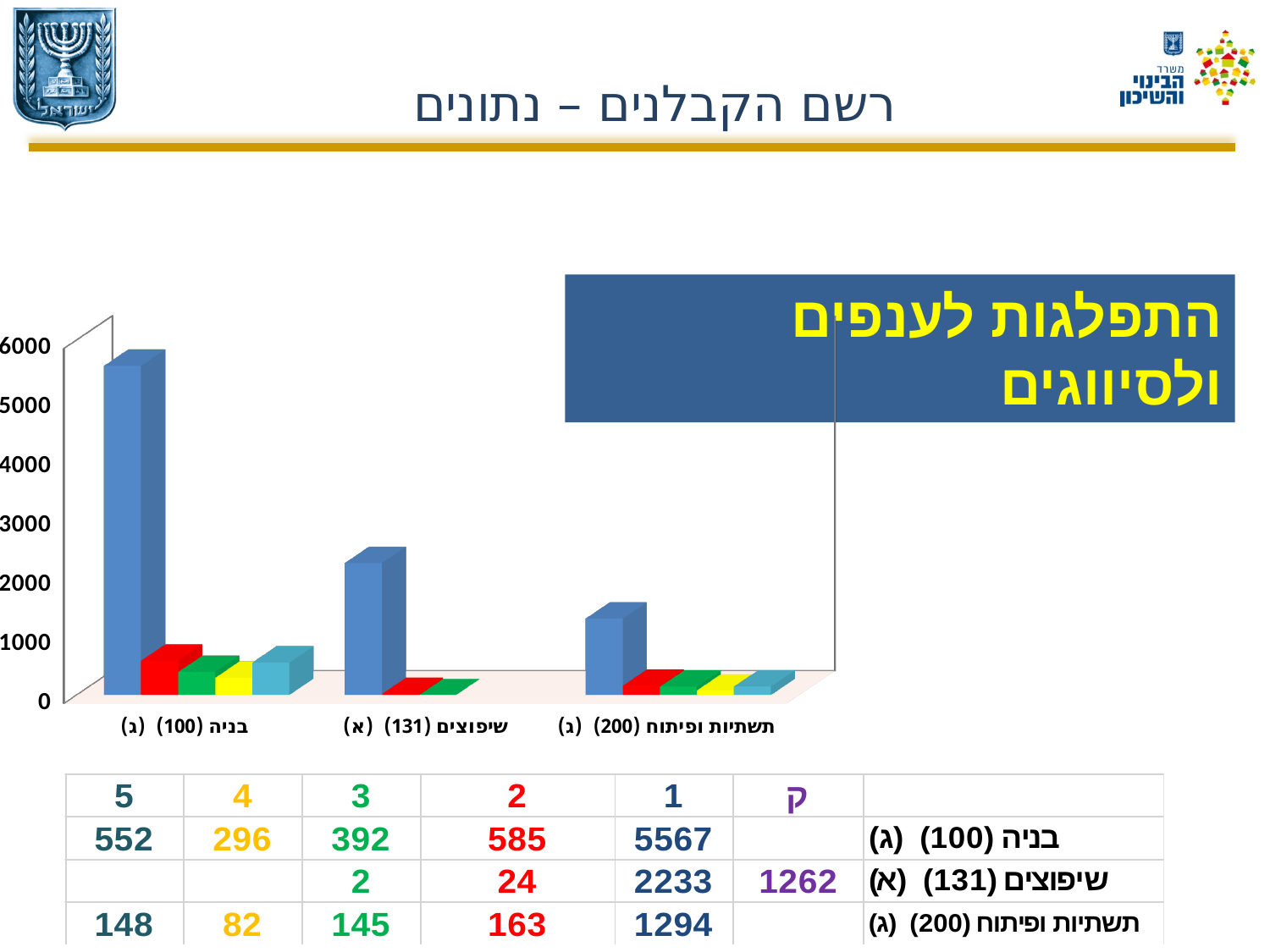
Is the series 1 value for שיפוצים (131) (א) greater or less than 2000? greater What kind of chart is shown on the slide? bar chart What is the difference between the series 3 values for בניה (100) (ג) and תשתיות ופיתוח (200) (ג)? 247 What is the value of series ק for שיפוצים (131) (א)? 1262 Which category has the highest value for series 1? בניה (100) (ג) Which category has the lowest value for series 1? תשתיות ופיתוח (200) (ג) What is the value of series 5 for תשתיות ופיתוח (200) (ג)? 148 What is the difference between the series 1 values for בניה (100) (ג) and שיפוצים (131) (א)? 3334 Which is larger: the series 2 value for בניה (100) (ג) or for תשתיות ופיתוח (200) (ג)? בניה (100) (ג) What is the value of series 1 for בניה (100) (ג)? 5567 How many categories are shown along the x axis of the chart? 3 What is the value of series 2 for שיפוצים (131) (א)? 24